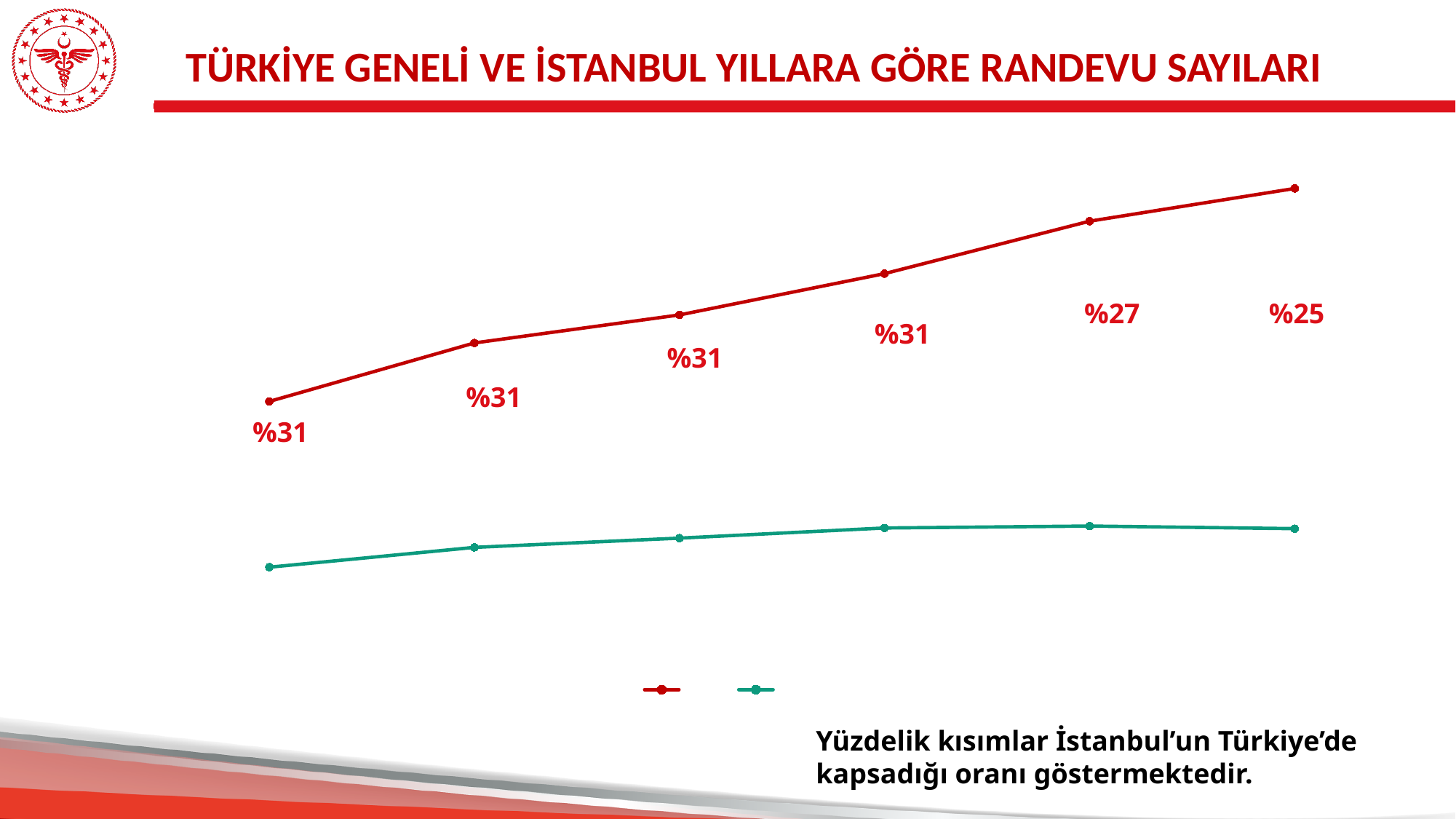
What is the leftmost percentage label shown on the chart? %31 How many data points does the green line have? 6 What kind of chart is shown on the slide? line chart How many of the percentage labels on the chart read %31? 4 What is the lowest percentage label shown on the chart? %25 Does the red line rise or fall from left to right? rises What is the fifth percentage label from the left on the chart? %27 What is the title of the slide? TÜRKİYE GENELİ VE İSTANBUL YILLARA GÖRE RANDEVU SAYILARI Which line has the higher values throughout the chart, the red line or the green line? the red line What is the rightmost percentage label shown on the chart? %25 How many data points does the red line have? 6 How many series does the legend show? 2